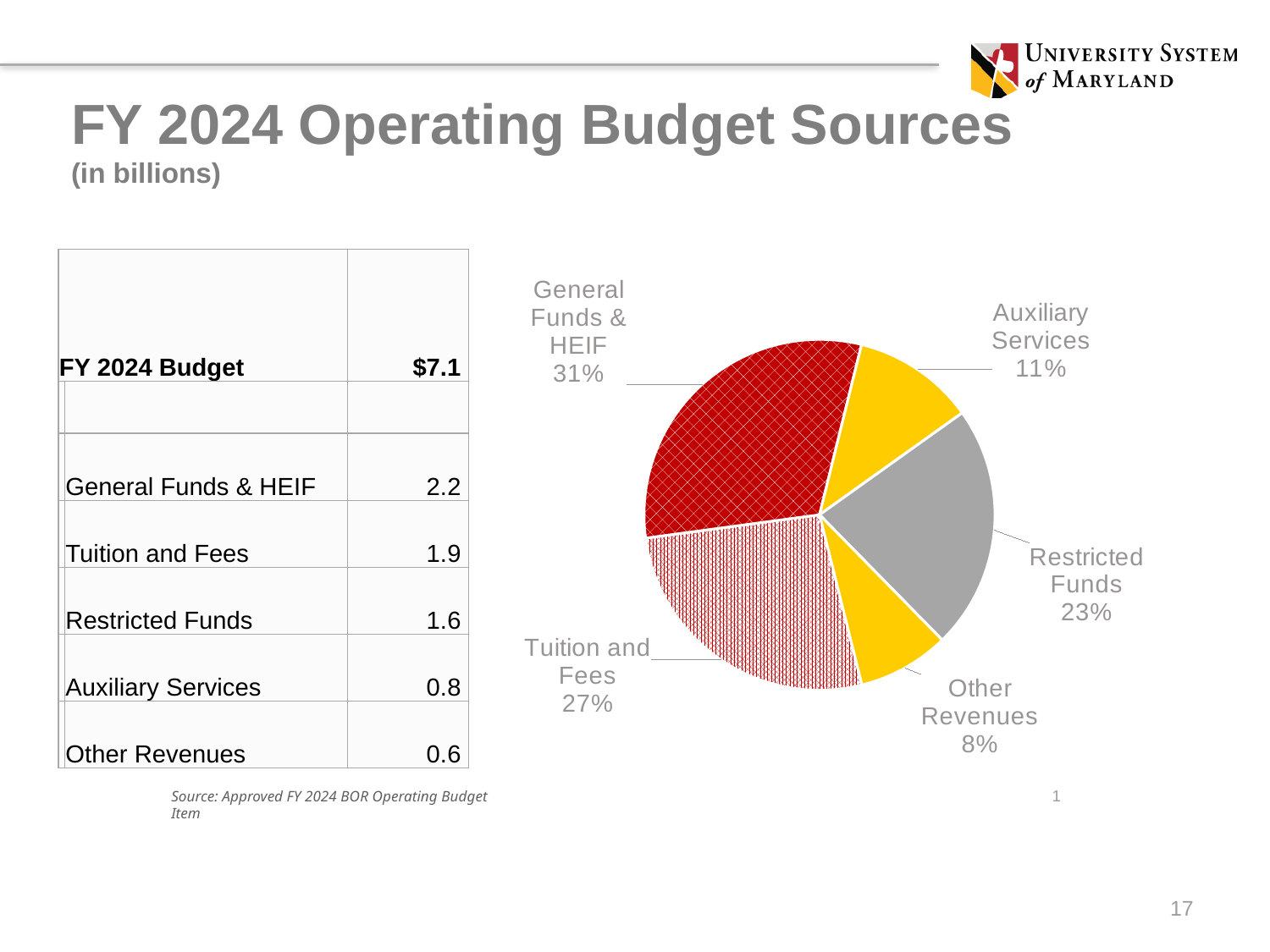
What share of the pie does Other Revenues represent? 8% What is the difference in percentage points between the General Funds & HEIF slice and the Tuition and Fees slice? 4 percentage points Which is larger in the pie chart, Restricted Funds or Auxiliary Services? Restricted Funds Which slice of the pie chart is the smallest? Other Revenues What share of the pie does Tuition and Fees represent? 27% Which slice of the pie chart is the largest? General Funds & HEIF What share of the pie does Auxiliary Services represent? 11% How many slices does the pie chart have? 5 What kind of chart is shown on the slide? Pie chart What is the title of the slide containing the pie chart? FY 2024 Operating Budget Sources